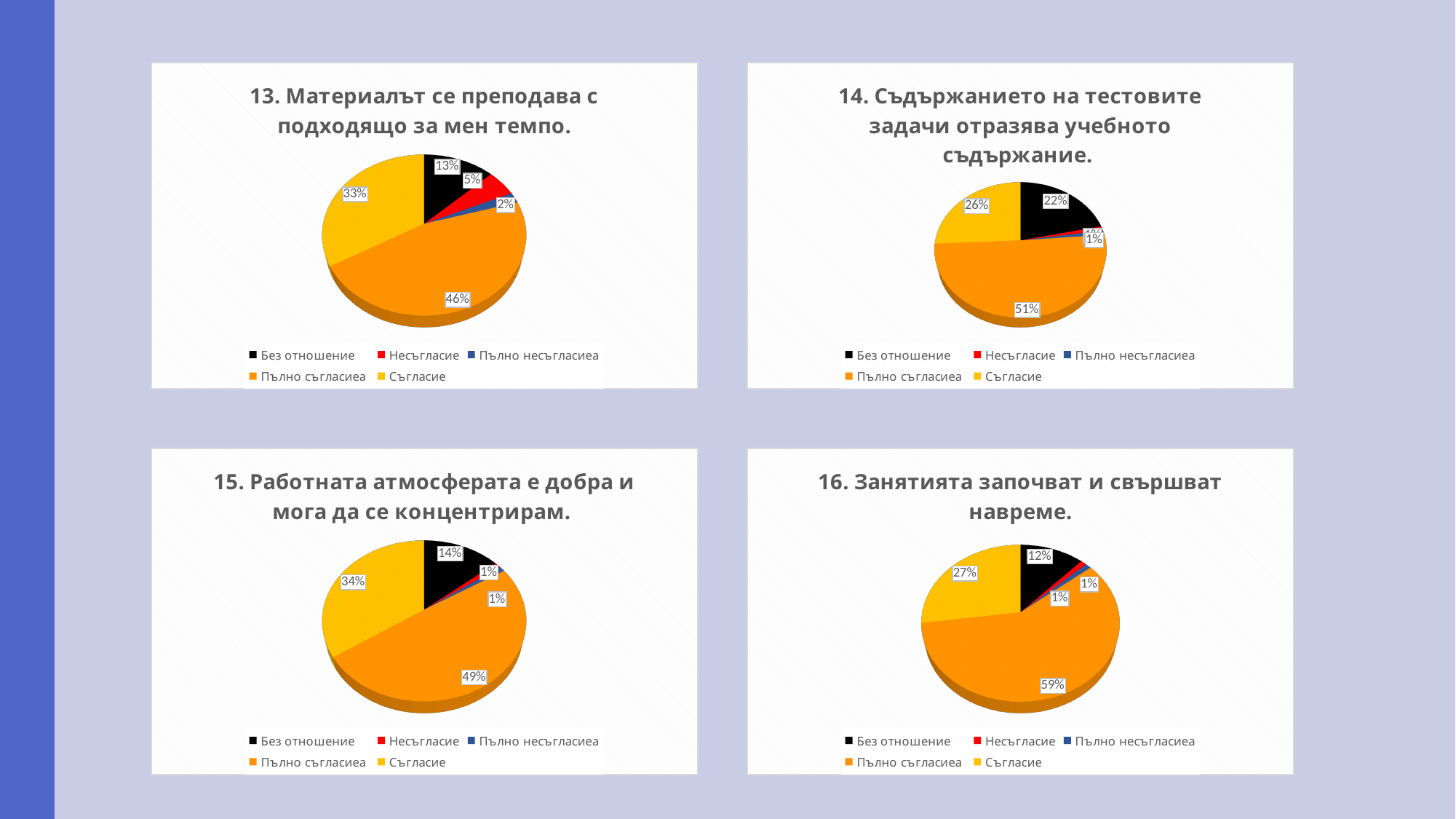
What type of chart is used in the chart titled "14. Съдържанието на тестовите задачи отразява учебното съдържание."? Pie chart In the chart titled "14. Съдържанието на тестовите задачи отразява учебното съдържание.", what share does "Без отношение" have? 22% In the chart titled "15. Работната атмосферата е добра и мога да се концентрирам.", what share does "Съгласие" have? 34% How many charts are shown on the slide? 4 In the chart titled "13. Материалът се преподава с подходящо за мен темпо.", what is the combined share of "Пълно съгласиеа" and "Съгласие"? 79% In the chart titled "16. Занятията започват и свършват навреме.", what share does "Пълно съгласиеа" have? 59% In the chart titled "13. Материалът се преподава с подходящо за мен темпо.", what share does "Пълно съгласиеа" have? 46% In the chart titled "14. Съдържанието на тестовите задачи отразява учебното съдържание.", which category has the largest slice? Пълно съгласиеа In the chart titled "13. Материалът се преподава с подходящо за мен темпо.", what share does "Несъгласие" have? 5% In the chart titled "16. Занятията започват и свършват навреме.", which is larger, "Съгласие" or "Без отношение"? Съгласие How many categories does the legend list in the chart titled "16. Занятията започват и свършват навреме."? 5 In the chart titled "15. Работната атмосферата е добра и мога да се концентрирам.", what is the difference between the shares of "Пълно съгласиеа" and "Без отношение"? 35%